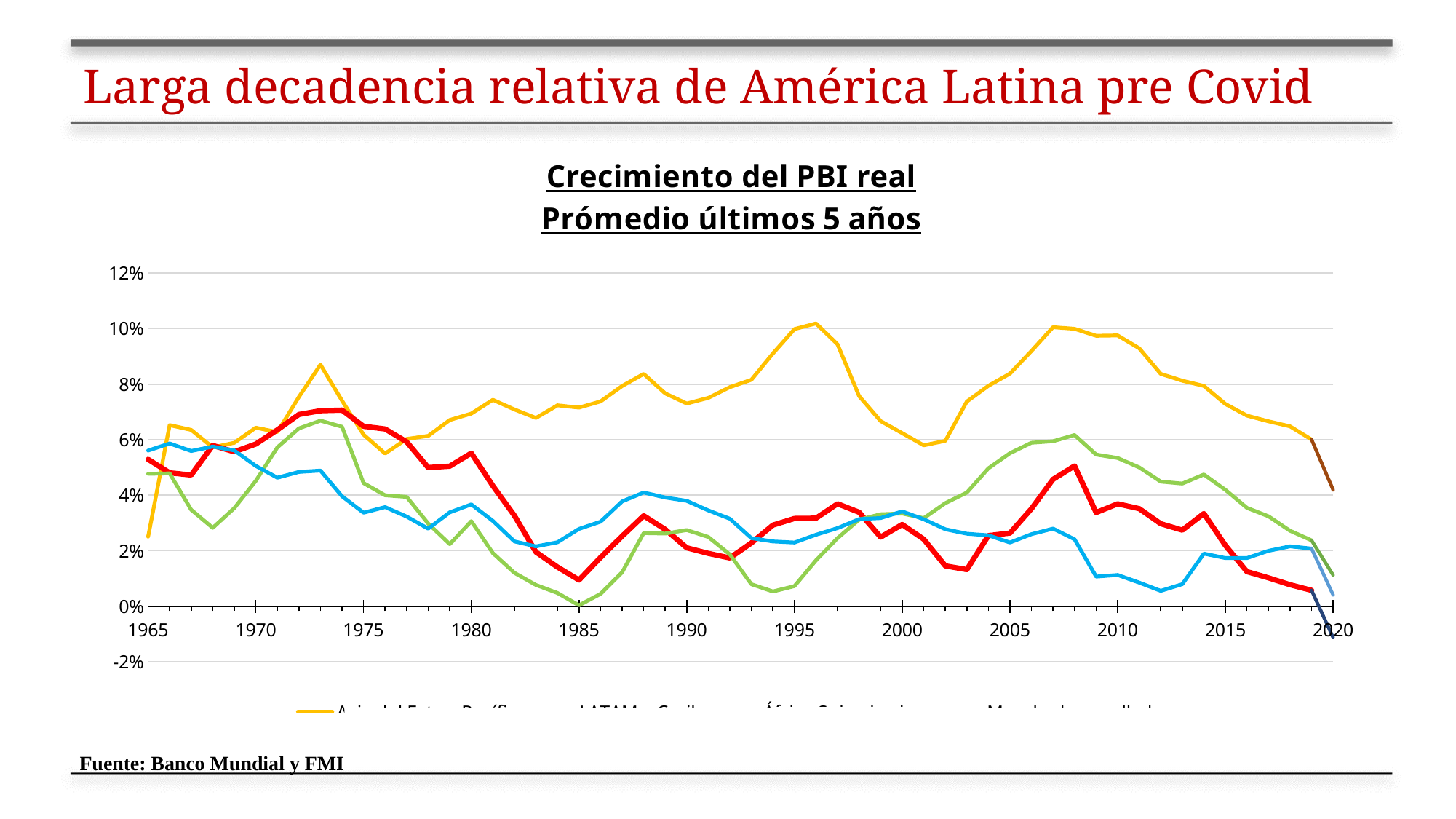
Is the value of the yellow line in 1965 greater or less than 4%? less Is the value of the red line in 1974 greater or less than 6%? greater In 2008, which is larger: the value of the red line or the value of the blue line? the red line What is the title of the chart? Crecimiento del PBI real Prómedio últimos 5 años How many series does the legend of the chart list? 4 Does the yellow line rise or fall between 2007 and 2020? fall What kind of chart is shown on the slide? line chart Which line has the lowest value in 1985? the green line Is the value of the yellow line in 1973 greater or less than 8%? greater What is the first year shown on the x axis of the chart? 1965 Which line has the highest value in 2010? the yellow line